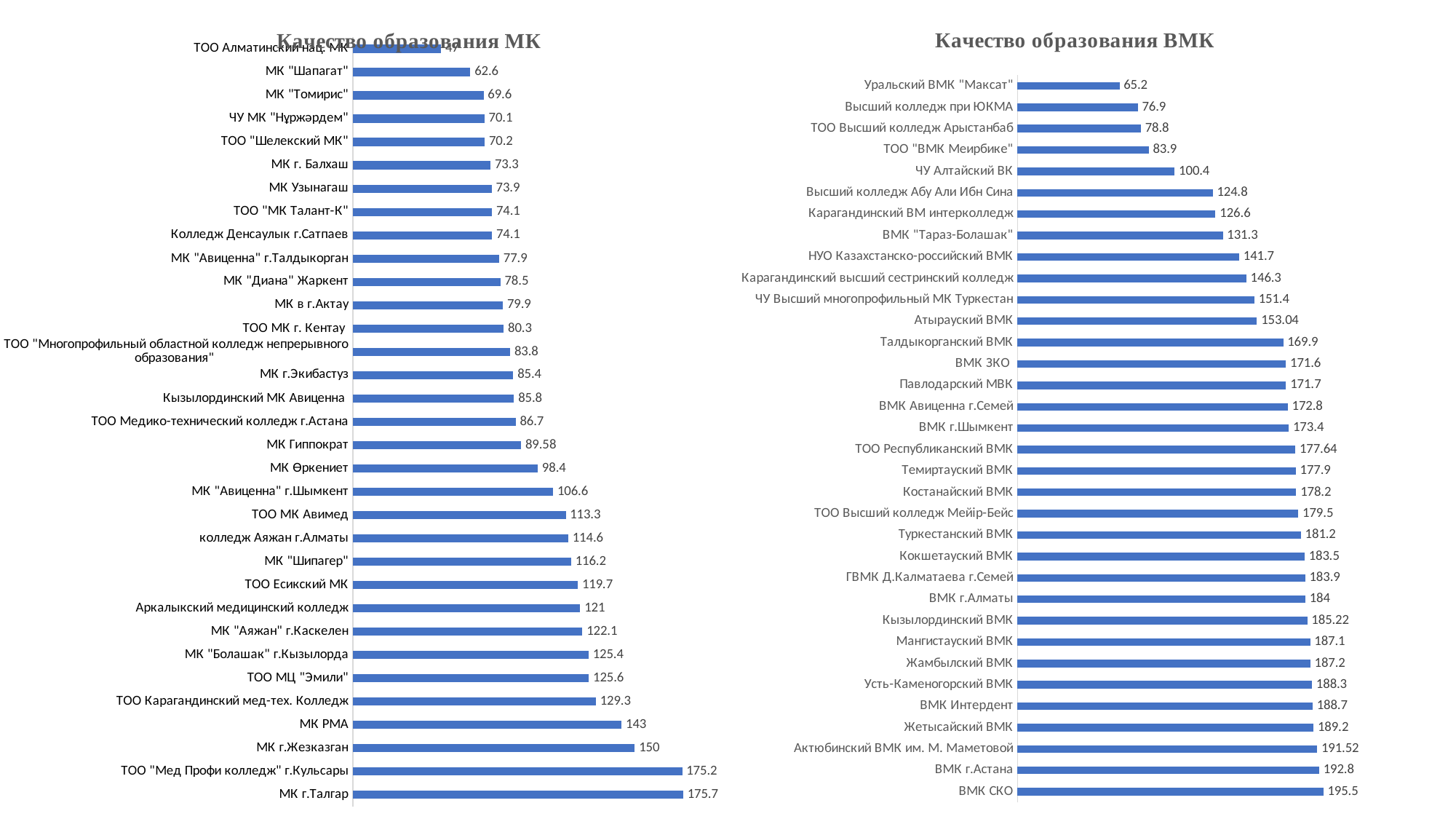
On the chart titled "Качество образования МК", which is larger: МК РМА or ТОО МЦ "Эмили"? МК РМА On the chart titled "Качество образования МК", what is the value for МК г.Талгар? 175.7 On the chart titled "Качество образования ВМК", what is the value for Атырауский ВМК? 153.04 What kind of chart is the chart titled "Качество образования МК"? Bar chart On the chart titled "Качество образования ВМК", what is the difference between ВМК СКО and ВМК г.Астана? 2.7 How many categories are shown on the chart titled "Качество образования ВМК"? 34 On the chart titled "Качество образования МК", what is the difference between МК г.Талгар and МК г.Жезказган? 25.7 On the chart titled "Качество образования ВМК", which category has the lowest value? Уральский ВМК "Максат" On the chart titled "Качество образования МК", which category has the highest value? МК г.Талгар On the chart titled "Качество образования МК", what is the value for МК Гиппократ? 89.58 On the chart titled "Качество образования ВМК", which is larger: ЧУ Алтайский ВК or ВМК "Тараз-Болашак"? ВМК "Тараз-Болашак" On the chart titled "Качество образования ВМК", which category has the highest value? ВМК СКО